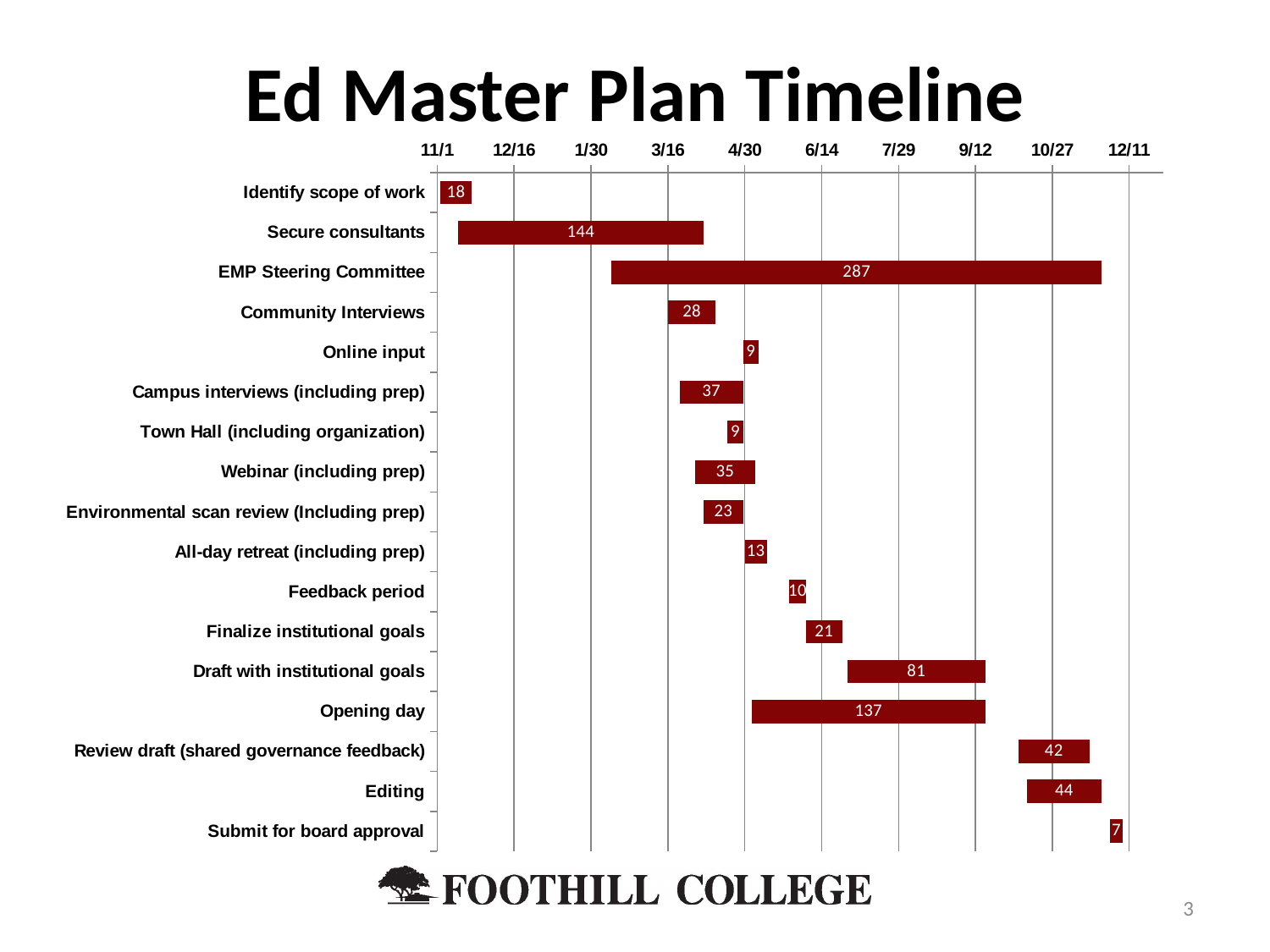
What kind of chart is shown on the slide? Bar chart What is the value shown for Opening day? 137 What is the difference between the values for Editing and Review draft (shared governance feedback)? 2 Which task has the highest value? EMP Steering Committee What is the value shown for EMP Steering Committee? 287 What is the title of the chart? Ed Master Plan Timeline What is the value shown for Editing? 44 What is the value shown for Secure consultants? 144 What is the difference between the values for Opening day and Draft with institutional goals? 56 How many tasks are listed on the chart? 17 Which is larger, the value for Campus interviews (including prep) or the value for Webinar (including prep)? Campus interviews (including prep) Which task has the lowest value? Submit for board approval